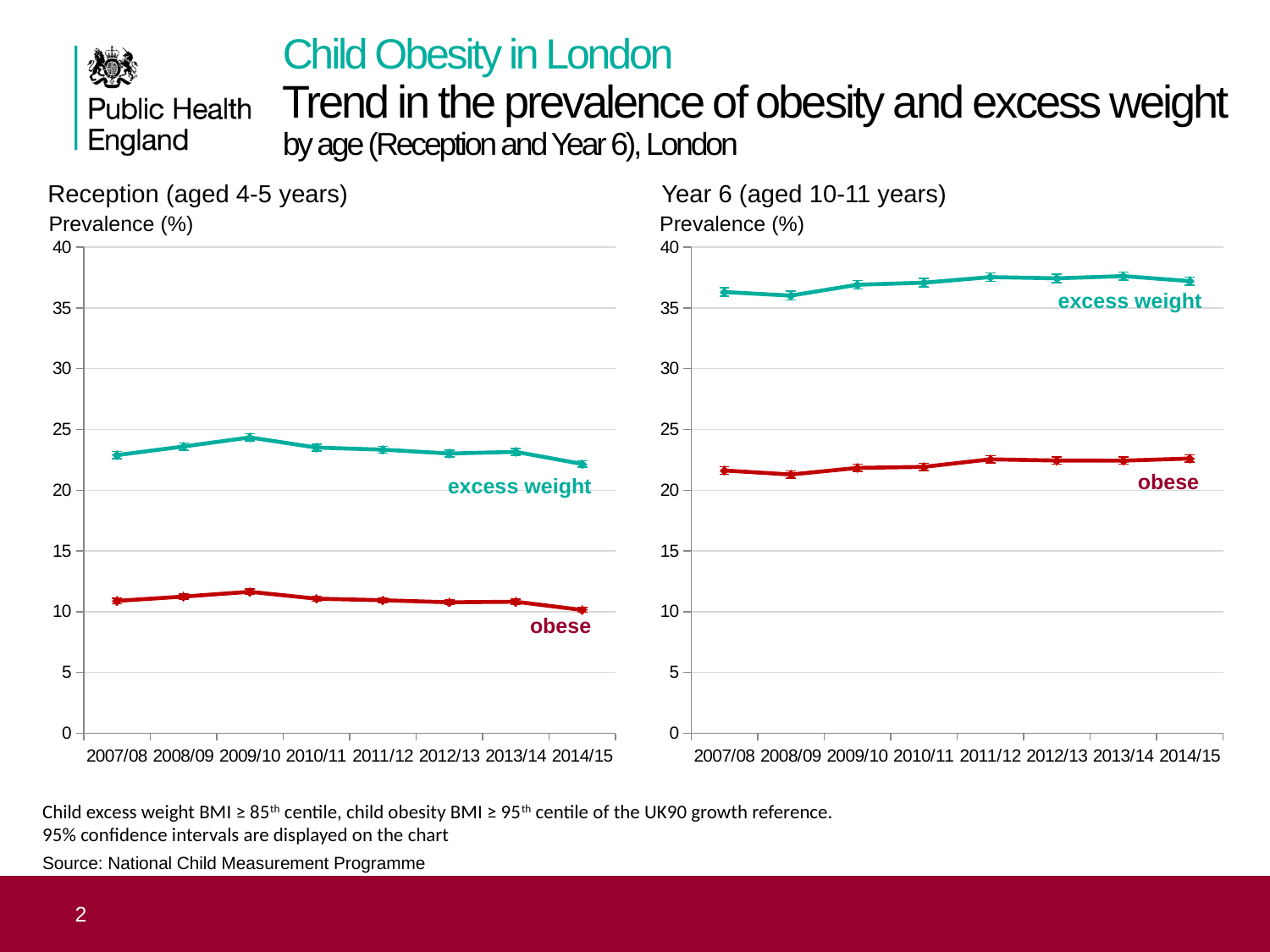
On the Reception (aged 4-5 years) chart, is the obese value for 2009/10 greater or less than 10? greater Which is larger in 2014/15: the excess weight prevalence on the Year 6 chart or the excess weight prevalence on the Reception chart? Year 6 On the Reception (aged 4-5 years) chart, in which year is the obese prevalence highest? 2009/10 On the Reception (aged 4-5 years) chart, in which year is the excess weight prevalence lowest? 2014/15 How many lines are plotted on the Reception (aged 4-5 years) chart? 2 How many school years are plotted along the x axis of the Year 6 (aged 10-11 years) chart? 8 On the Reception (aged 4-5 years) chart, is the excess weight value for 2009/10 greater or less than 25? less On the Reception (aged 4-5 years) chart, in which year is the excess weight prevalence highest? 2009/10 On the Year 6 (aged 10-11 years) chart, does the excess weight prevalence rise or fall overall from 2007/08 to 2014/15? rise What kind of chart is the Reception (aged 4-5 years) chart? line chart On the Year 6 (aged 10-11 years) chart, is the obese value for 2011/12 greater or less than 25? less